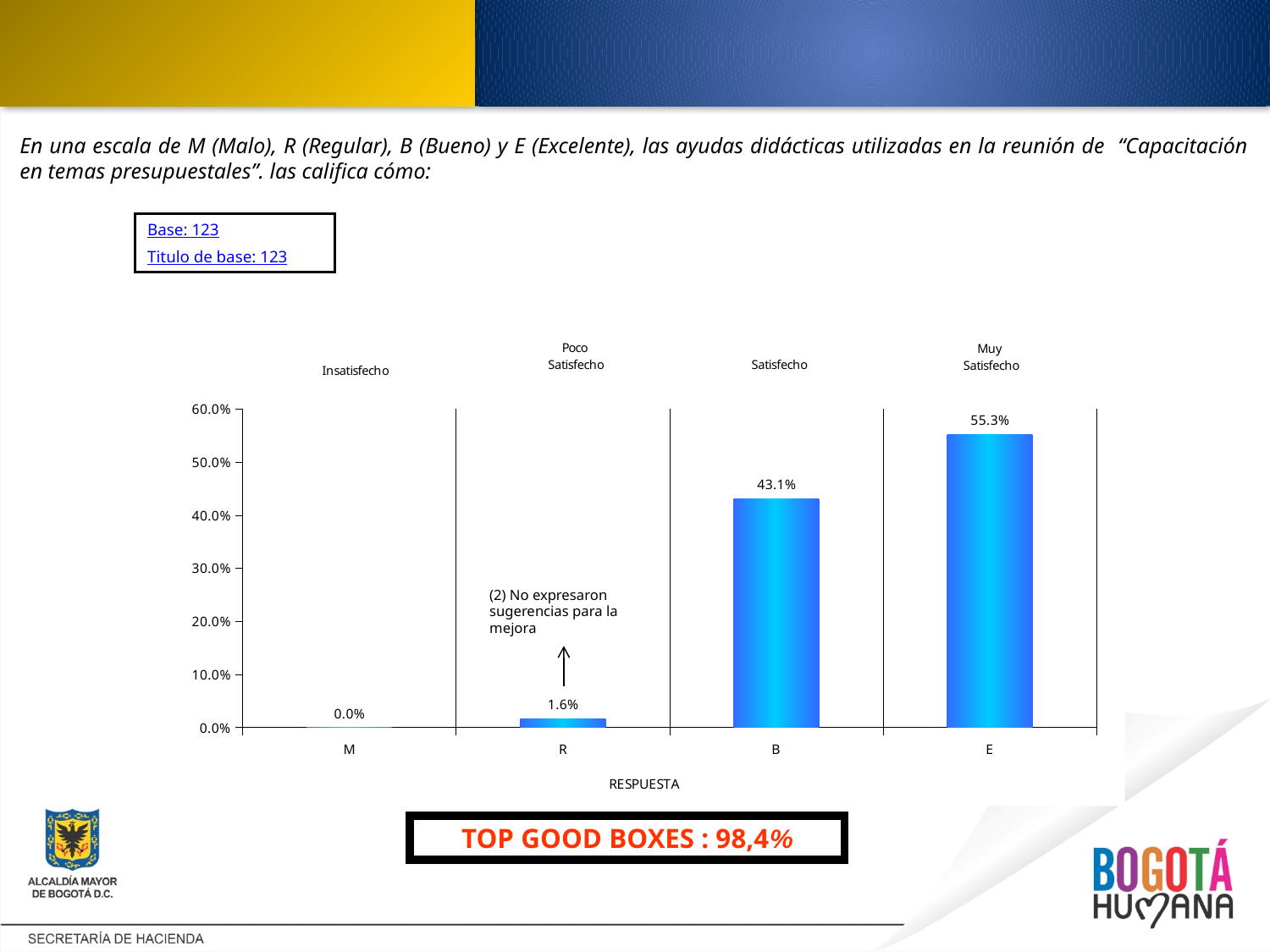
What is the value for category E? 55.3% Which category has the lowest value? M What is the value for category R? 1.6% Is the value for B greater or less than 40.0%? greater Which is larger, the value for B or the value for R? B Which category has the highest value? E What kind of chart is shown on the slide? bar chart What is the value for category B? 43.1% What is the x-axis title of the chart? RESPUESTA What is the value for category M? 0.0% How many categories are shown on the x axis? 4 What is the difference between the values for E and B? 12.2%